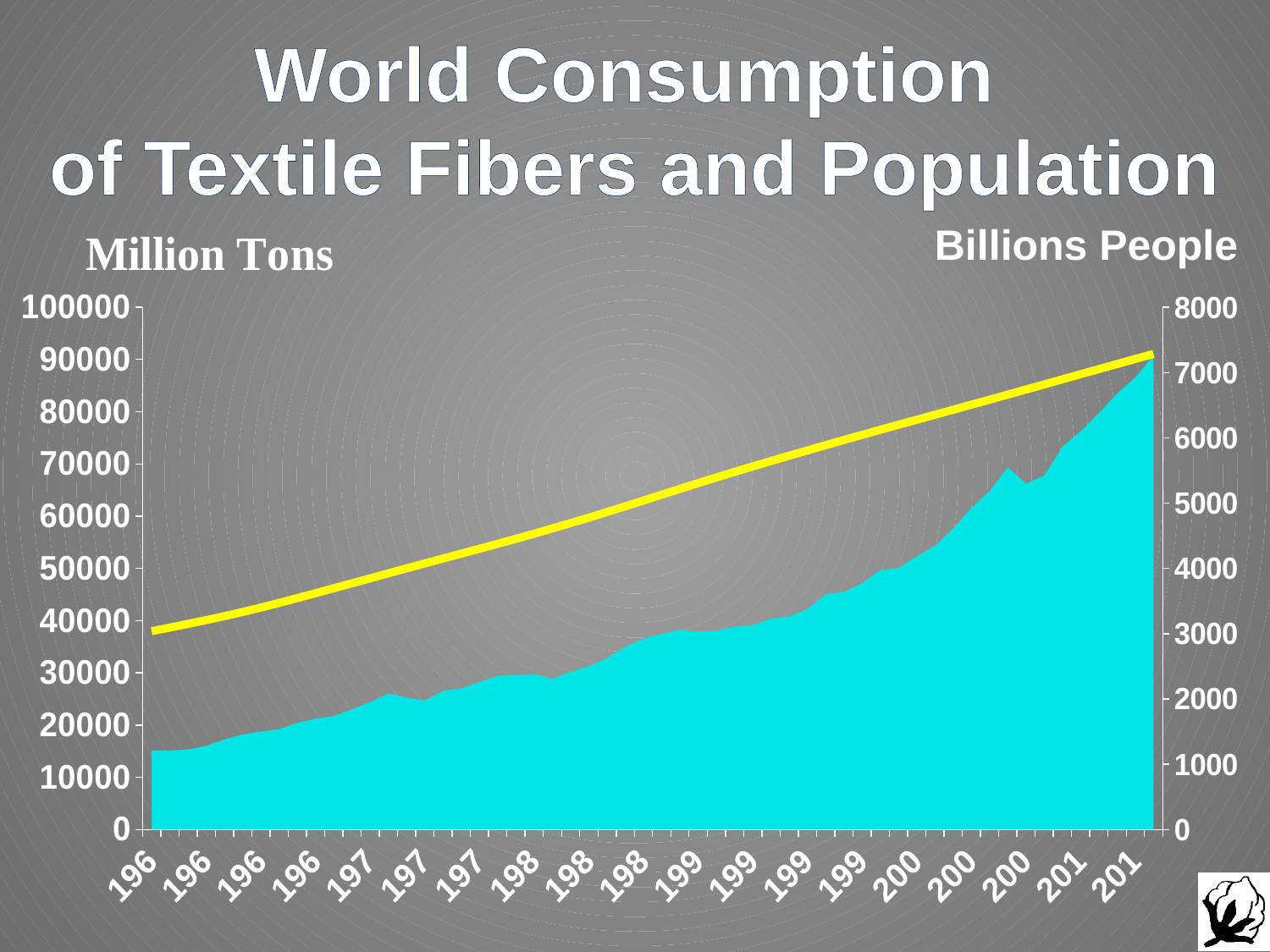
Is the value of the yellow line at the far left of the chart greater or less than 4000 on the right axis? less What unit label is shown above the left vertical axis? Million Tons Does the cyan shaded area generally rise or fall from left to right? rise What kind of chart is shown on the slide? area chart with a line overlay What is the title of the chart? World Consumption of Textile Fibers and Population Does the yellow line rise or fall from left to right across the chart? rise Is the value of the cyan area at the far right of the chart greater or less than 80000 on the left axis? greater Is the value of the cyan area at the far left of the chart greater or less than 20000 on the left axis? less